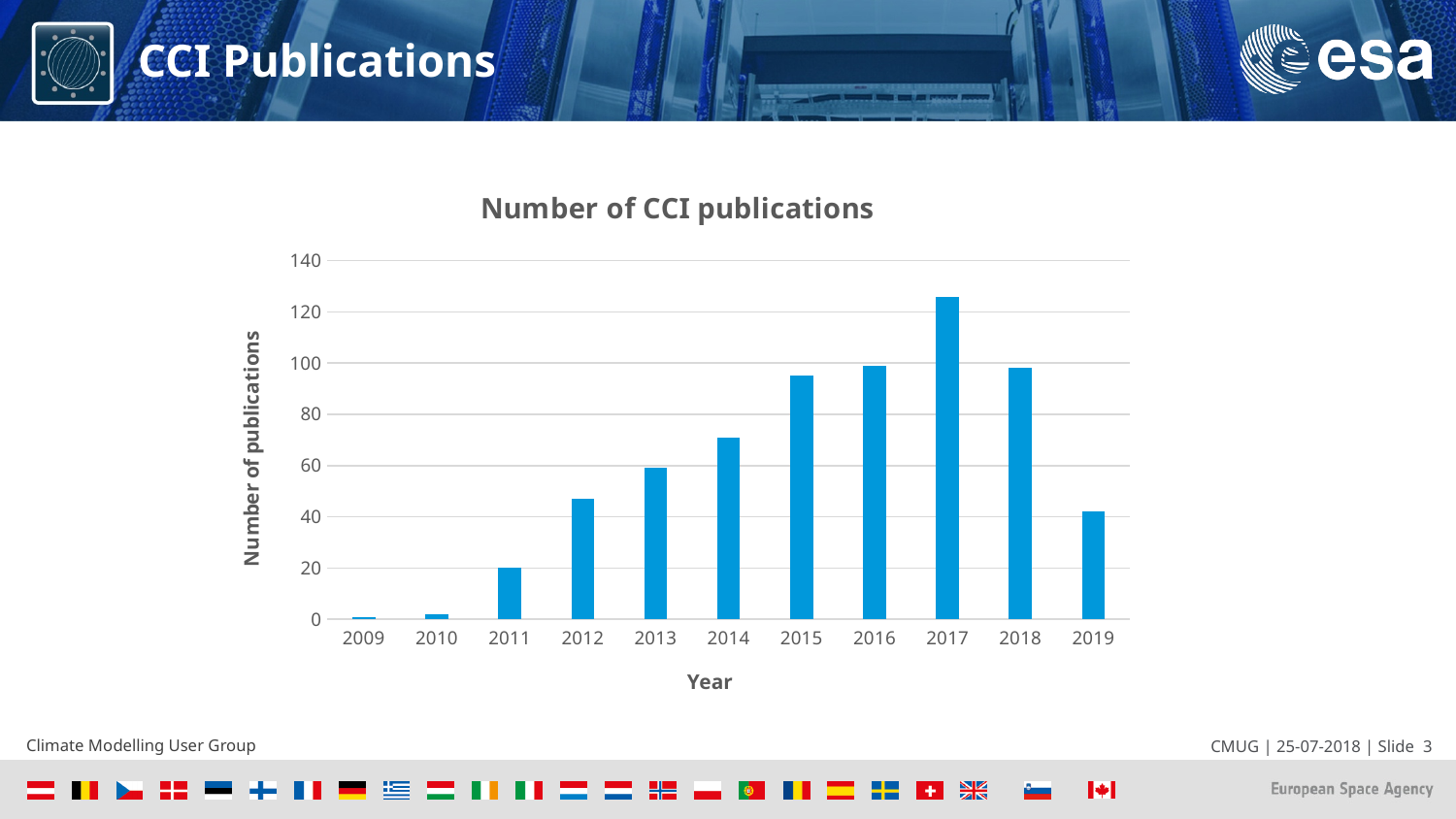
Is the number of publications for 2015 greater or less than 100? less Which year has more publications, 2014 or 2018? 2018 What is the title of the chart? Number of CCI publications Which year has the highest number of CCI publications? 2017 Is the number of publications for 2019 greater or less than 60? less Is the number of publications for 2014 greater or less than 80? less Do the number of publications rise or fall from 2009 to 2017? rise What is the label of the vertical axis? Number of publications What kind of chart is shown on the slide? bar chart How many years are shown on the x axis of the chart? 11